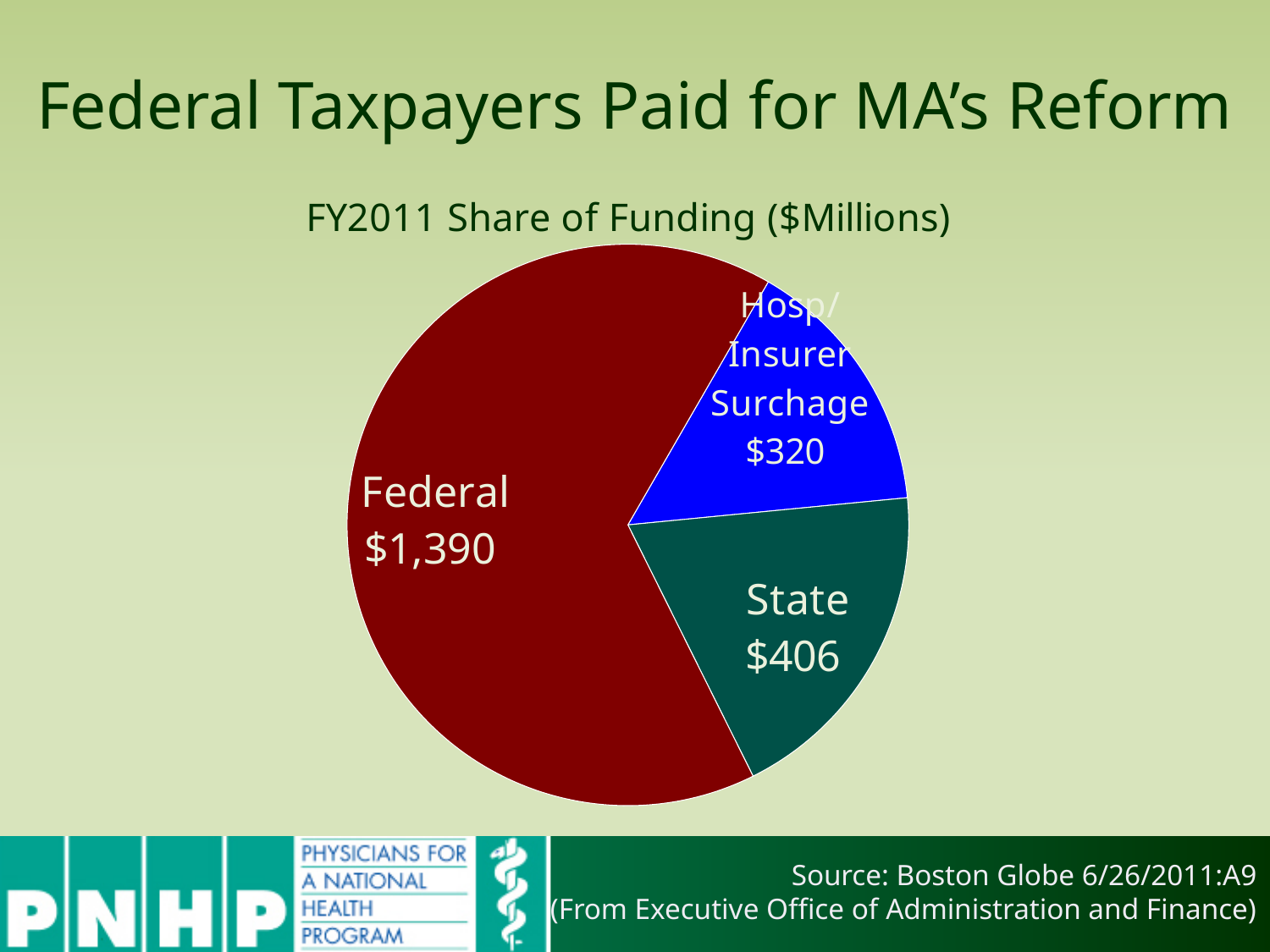
What is the difference between the State and Hosp/Insurer Surchage values in the pie chart? $86 What is the difference between the Federal and State values in the pie chart? $984 What is the value of the State slice in the pie chart? $406 What is the value of the Hosp/Insurer Surchage slice in the pie chart? $320 What is the total of all slices in the pie chart? $2,116 Which slice of the pie chart is the largest? Federal Which is larger in the pie chart, State or Hosp/Insurer Surchage? State What is the title of the chart on the slide? FY2011 Share of Funding ($Millions) How many slices does the pie chart have? 3 What kind of chart is shown on the slide? Pie chart What is the value of the Federal slice in the pie chart? $1,390 Which slice of the pie chart is the smallest? Hosp/Insurer Surchage